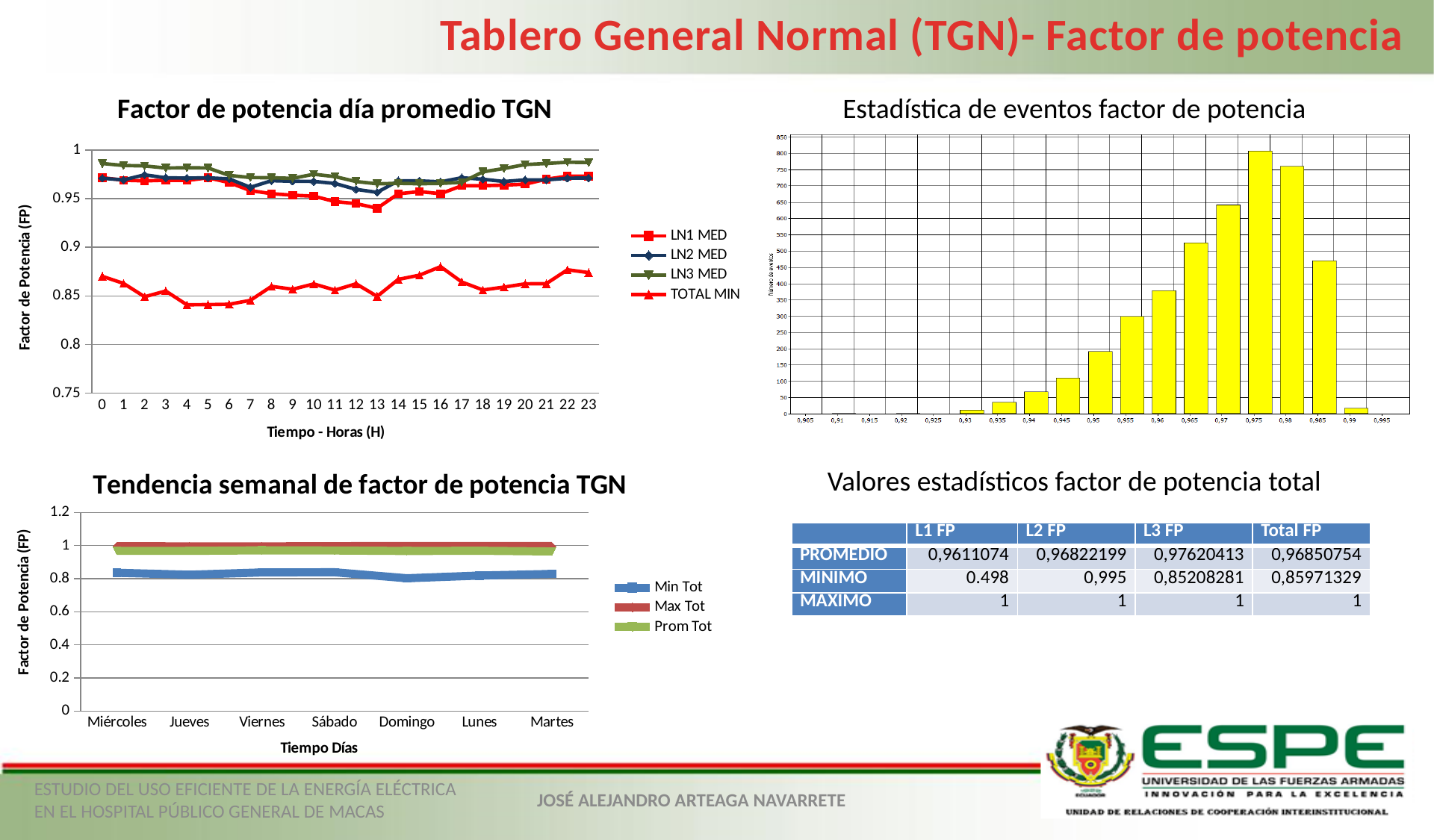
What kind of chart is 'Estadística de eventos factor de potencia'? bar chart In the chart 'Factor de potencia día promedio TGN', how many series does the legend list? 4 In the chart 'Tendencia semanal de factor de potencia TGN', which day has the lowest Min Tot value? Domingo What is the x-axis title of the chart 'Factor de potencia día promedio TGN'? Tiempo - Horas (H) In the chart 'Tendencia semanal de factor de potencia TGN', how many days are shown on the x axis? 7 In the chart 'Tendencia semanal de factor de potencia TGN', how many series does the legend list? 3 In the chart 'Estadística de eventos factor de potencia', is the bar at 0,95 greater or less than 250? less In the chart 'Factor de potencia día promedio TGN', is the value of LN3 MED at hour 0 greater or less than 0.95? greater In the chart 'Factor de potencia día promedio TGN', is the value of TOTAL MIN at hour 0 greater or less than 0.9? less In the chart 'Factor de potencia día promedio TGN', which series lies lowest across all hours? TOTAL MIN What kind of chart is 'Factor de potencia día promedio TGN'? line chart In the chart 'Estadística de eventos factor de potencia', which x-axis value has the tallest bar? 0,975